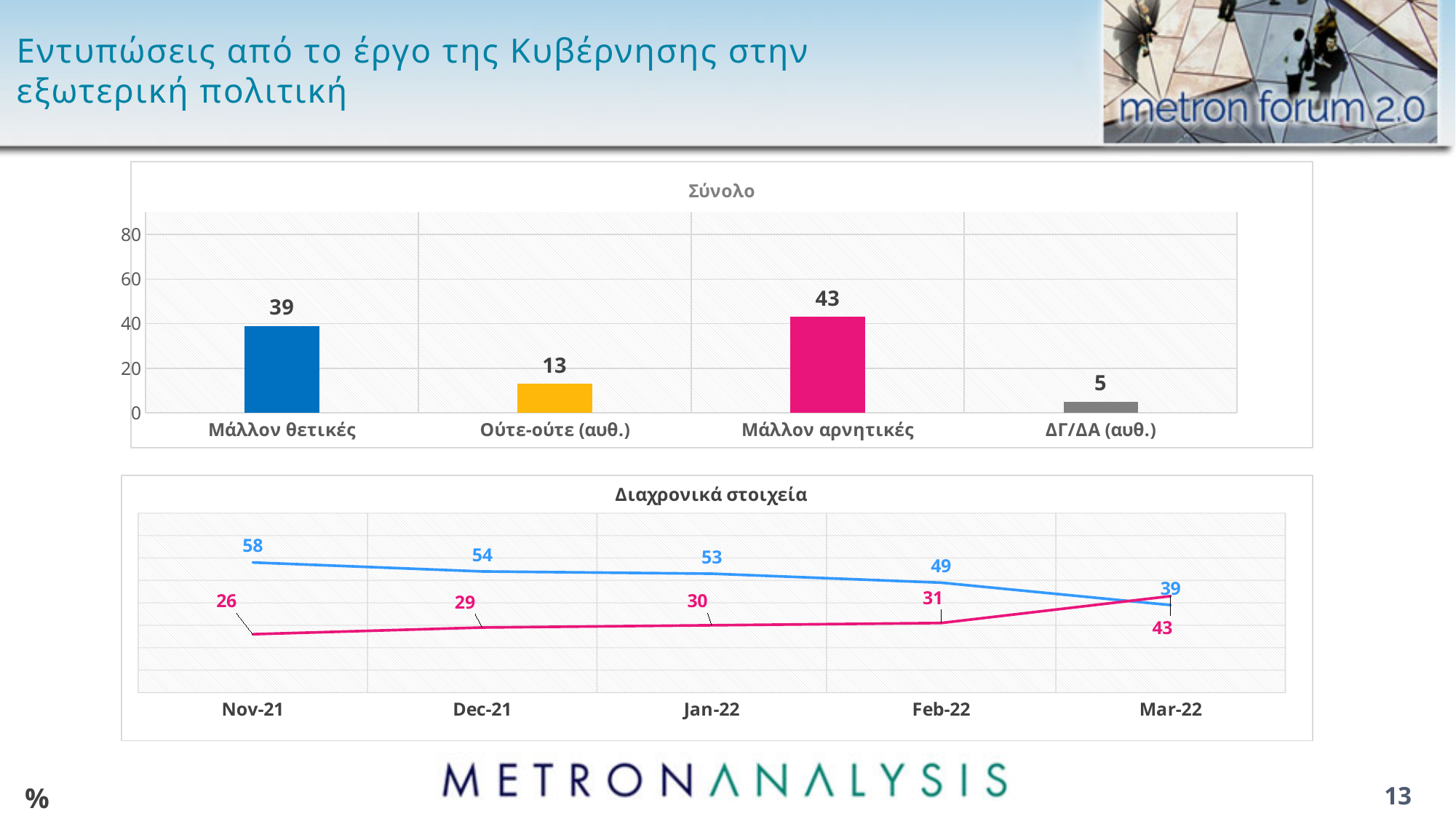
What kind of chart is the 'Σύνολο' chart? bar chart In the 'Διαχρονικά στοιχεία' chart, which is larger at Mar-22, the blue line or the pink line? the pink line In the 'Διαχρονικά στοιχεία' chart, what is the value of the pink line at Feb-22? 31 In the 'Διαχρονικά στοιχεία' chart, how many time points are plotted on the x axis? 5 In the 'Σύνολο' chart, what is the value for Μάλλον θετικές? 39 In the 'Σύνολο' chart, how many categories are shown? 4 In the 'Σύνολο' chart, which category has the lowest value? ΔΓ/ΔΑ (αυθ.) In the 'Σύνολο' chart, which category has the highest value? Μάλλον αρνητικές In the 'Διαχρονικά στοιχεία' chart, what is the value of the blue line at Nov-21? 58 In the 'Σύνολο' chart, what is the difference between Μάλλον αρνητικές and Μάλλον θετικές? 4 In the 'Διαχρονικά στοιχεία' chart, does the blue line rise or fall from Nov-21 to Mar-22? fall In the 'Σύνολο' chart, what is the value for ΔΓ/ΔΑ (αυθ.)? 5